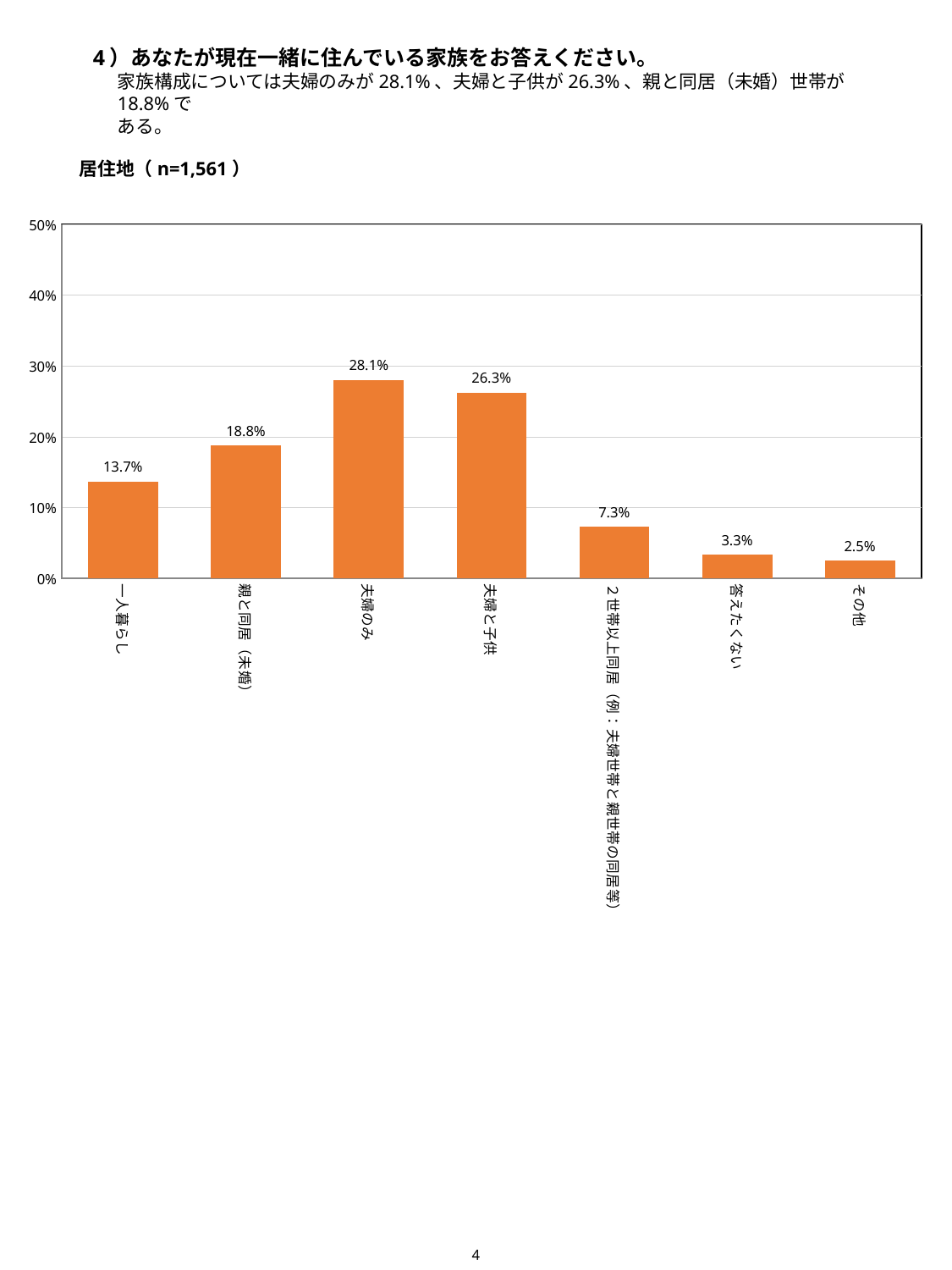
What is the difference between 親と同居（未婚） and 一人暮らし? 5.1% What is the value for 夫婦のみ? 28.1% Which is larger, 一人暮らし or 2世帯以上同居（例：夫婦世帯と親世帯の同居等）? 一人暮らし What is the sample size (n) shown in the chart heading? n=1,561 What is the value for 一人暮らし? 13.7% Which category has the lowest value? その他 Which category has the highest value? 夫婦のみ Is the value for 夫婦と子供 greater or less than 20%? greater How many categories are shown on the x axis? 7 What is the value for 答えたくない? 3.3% What kind of chart is this? bar chart What is the difference between 夫婦のみ and 夫婦と子供? 1.8%